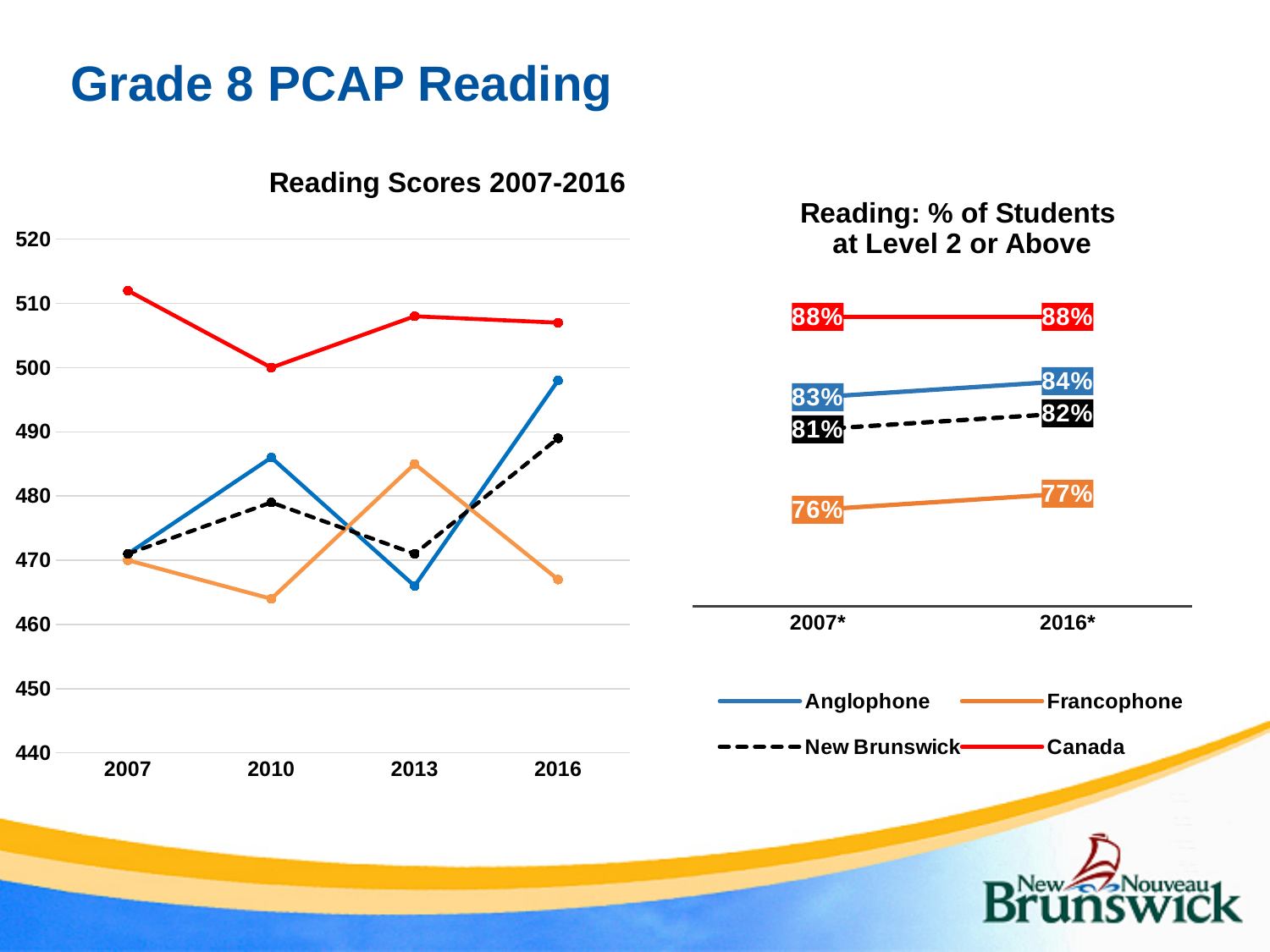
In the 'Reading: % of Students at Level 2 or Above' chart, which series has the lowest value in 2007*? Francophone In the 'Reading: % of Students at Level 2 or Above' chart, what is the value for New Brunswick in 2016*? 82% In the 'Reading: % of Students at Level 2 or Above' chart, what is the difference between Anglophone and Francophone in 2016*? 7% In the 'Reading: % of Students at Level 2 or Above' chart, what is the value for Canada in 2007*? 88% How many years are shown on the x axis of the 'Reading Scores 2007-2016' chart? 4 How many series does the legend list? 4 In the 'Reading: % of Students at Level 2 or Above' chart, what is the value for Francophone in 2016*? 77% In the 'Reading Scores 2007-2016' chart, is the value for Canada in 2007 greater or less than 510? greater In the 'Reading: % of Students at Level 2 or Above' chart, does the Anglophone value rise or fall from 2007* to 2016*? rise In the 'Reading: % of Students at Level 2 or Above' chart, which is larger in 2007*: Anglophone or New Brunswick? Anglophone In the 'Reading Scores 2007-2016' chart, which series has the highest value in 2016? Canada In the 'Reading Scores 2007-2016' chart, is the value for Anglophone in 2013 greater or less than 470? less